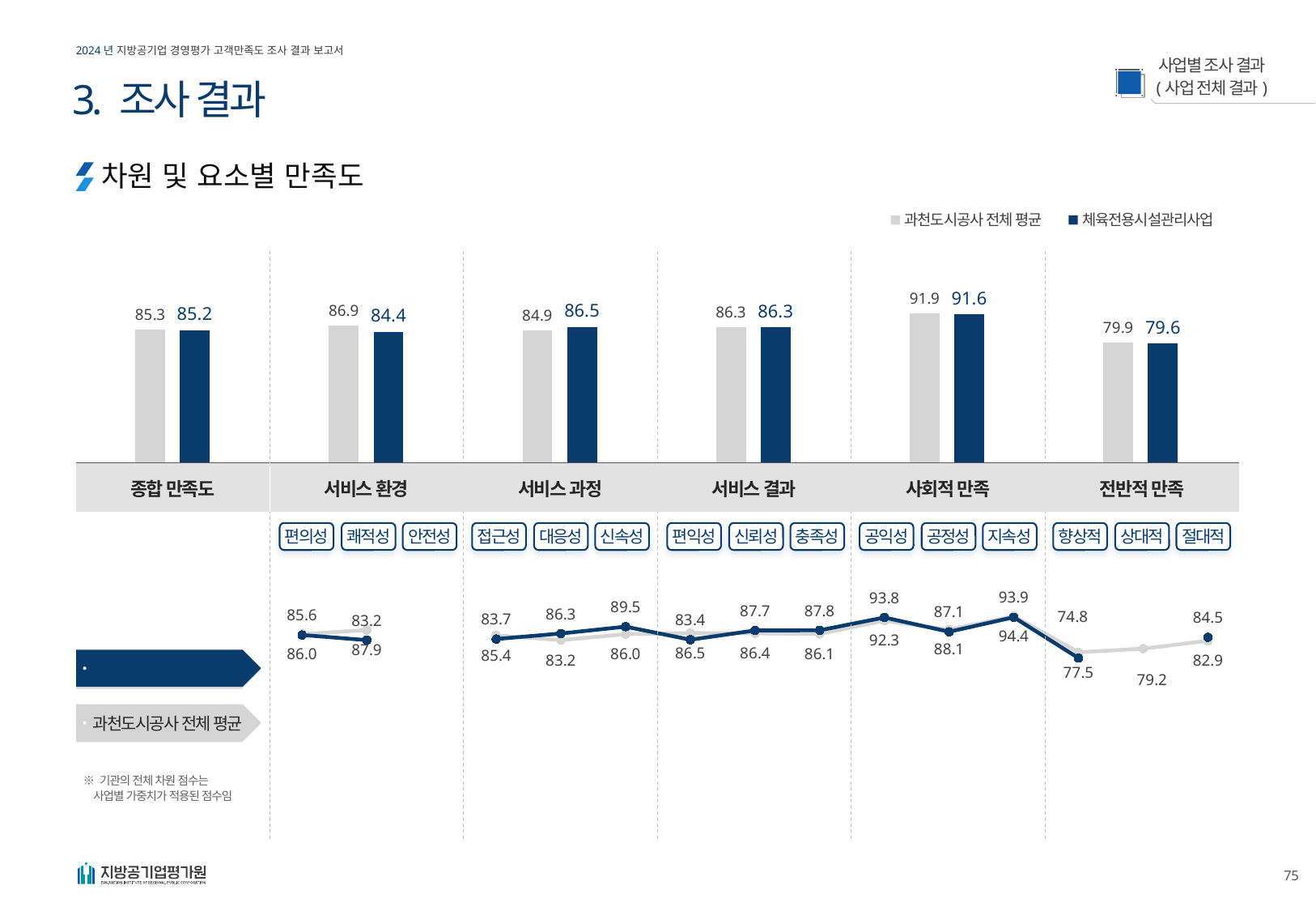
In the bar chart, which category has the highest value for 체육전용시설관리사업? 사회적 만족 How many series does the legend of the bar chart list? 2 In the bar chart, for 서비스 과정, which series has the larger value? 체육전용시설관리사업 In the bar chart, what is the value of 체육전용시설관리사업 for 사회적 만족? 91.6 In the bar chart, what is the value of 체육전용시설관리사업 for 종합 만족도? 85.2 What kind of chart is the upper chart on the slide? bar chart In the bar chart, what is the difference between 과천도시공사 전체 평균 and 체육전용시설관리사업 for 서비스 환경? 2.5 In the bar chart, what is the value of 과천도시공사 전체 평균 for 전반적 만족? 79.9 In the bar chart, which category has the lowest value for 과천도시공사 전체 평균? 전반적 만족 In the bar chart, what is the value of 과천도시공사 전체 평균 for 서비스 환경? 86.9 How many categories are shown in the bar chart? 6 In the bar chart, what is the difference between 체육전용시설관리사업 and 과천도시공사 전체 평균 for 서비스 과정? 1.6